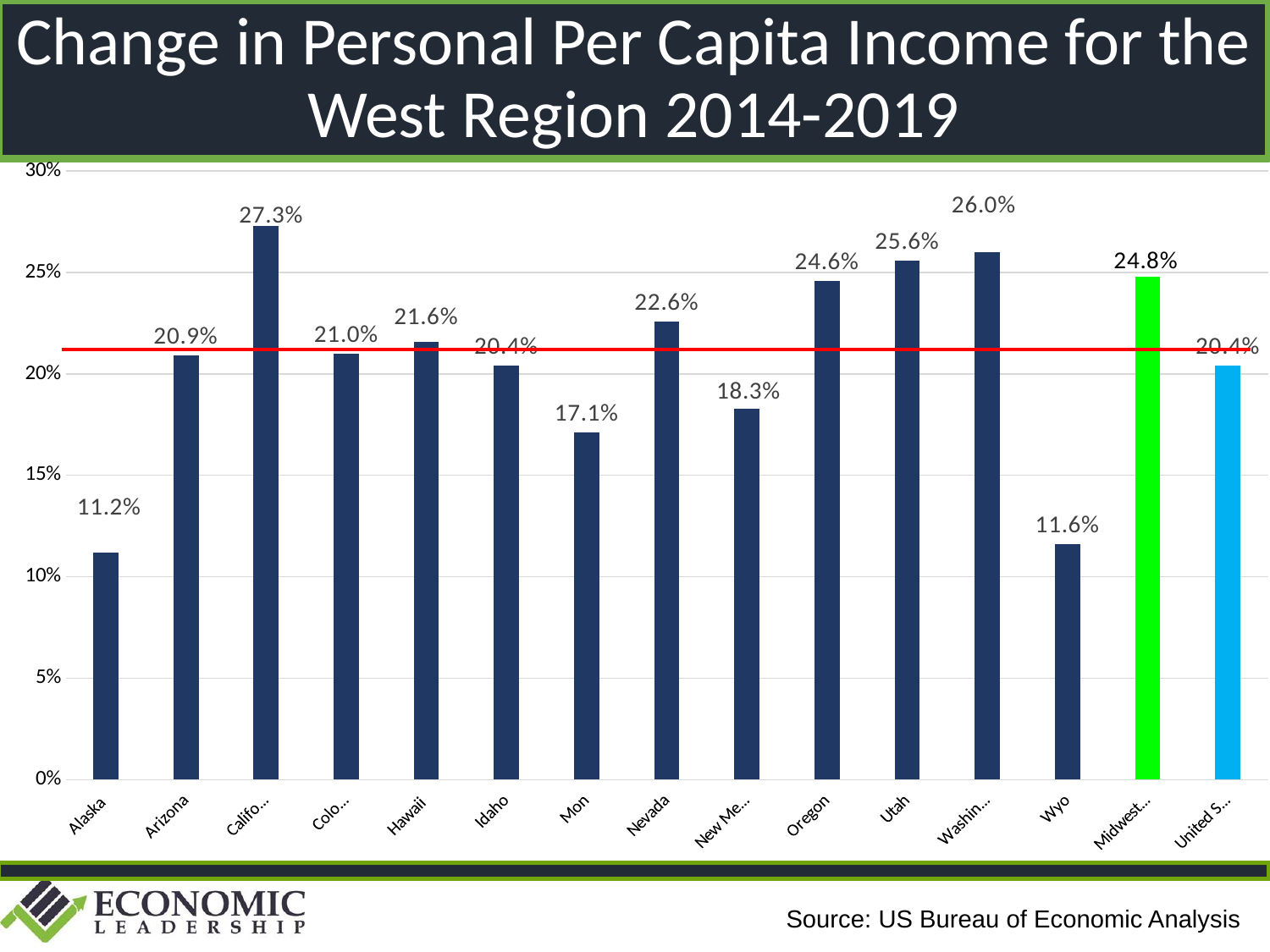
What is the value for Alaska? 11.2% What kind of chart is shown on the slide? bar chart Which category has the lowest value? Alaska What is the highest value shown on the chart? 27.3% Is the value for Mon greater or less than 20%? less Which is larger, the value for Nevada or the value for Hawaii? Nevada What is the difference between the values for Utah and Oregon? 1.0% What is the value for Nevada? 22.6% What is the value for Utah? 25.6% What is the value for Hawaii? 21.6% What is the value for Arizona? 20.9% How many bars are shown on the chart? 15